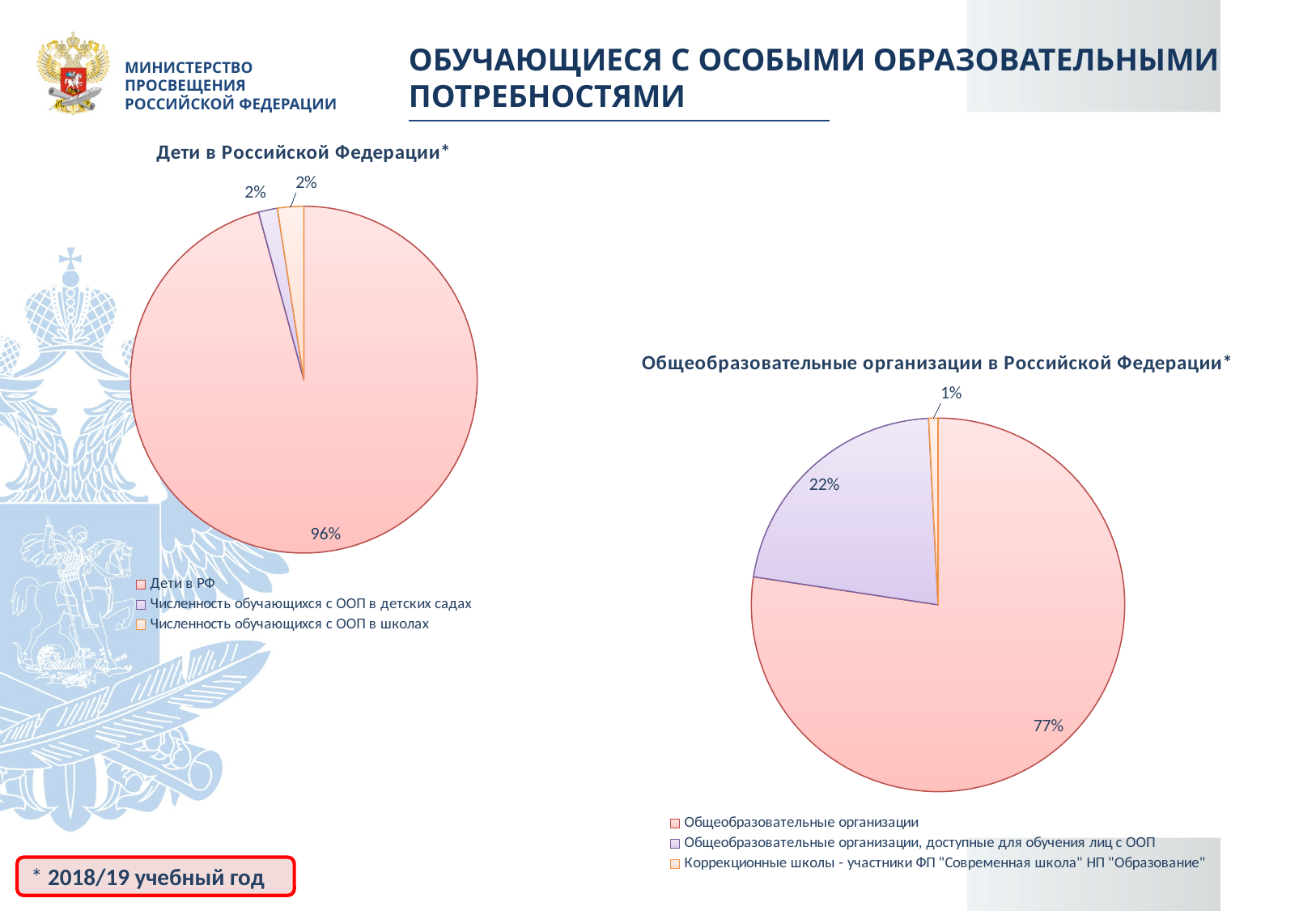
What kind of chart is the chart titled "Дети в Российской Федерации*"? pie chart How many pie charts are shown on the slide? 2 In the chart "Общеобразовательные организации в Российской Федерации*", what share does "Коррекционные школы - участники ФП "Современная школа" НП "Образование"" have? 1% In the chart "Общеобразовательные организации в Российской Федерации*", what share does "Общеобразовательные организации, доступные для обучения лиц с ООП" have? 22% In the chart "Дети в Российской Федерации*", what share does the slice "Дети в РФ" have? 96% In the chart "Дети в Российской Федерации*", which slice is the largest? Дети в РФ How many entries does the legend of the chart "Дети в Российской Федерации*" list? 3 What school year does the footnote on the slide refer to? 2018/19 учебный год In the chart "Общеобразовательные организации в Российской Федерации*", which is larger: "Общеобразовательные организации" or "Общеобразовательные организации, доступные для обучения лиц с ООП"? Общеобразовательные организации In the chart "Общеобразовательные организации в Российской Федерации*", what is the difference between the 77% slice and the 22% slice? 55% In the chart "Общеобразовательные организации в Российской Федерации*", which slice is the smallest? Коррекционные школы - участники ФП "Современная школа" НП "Образование"